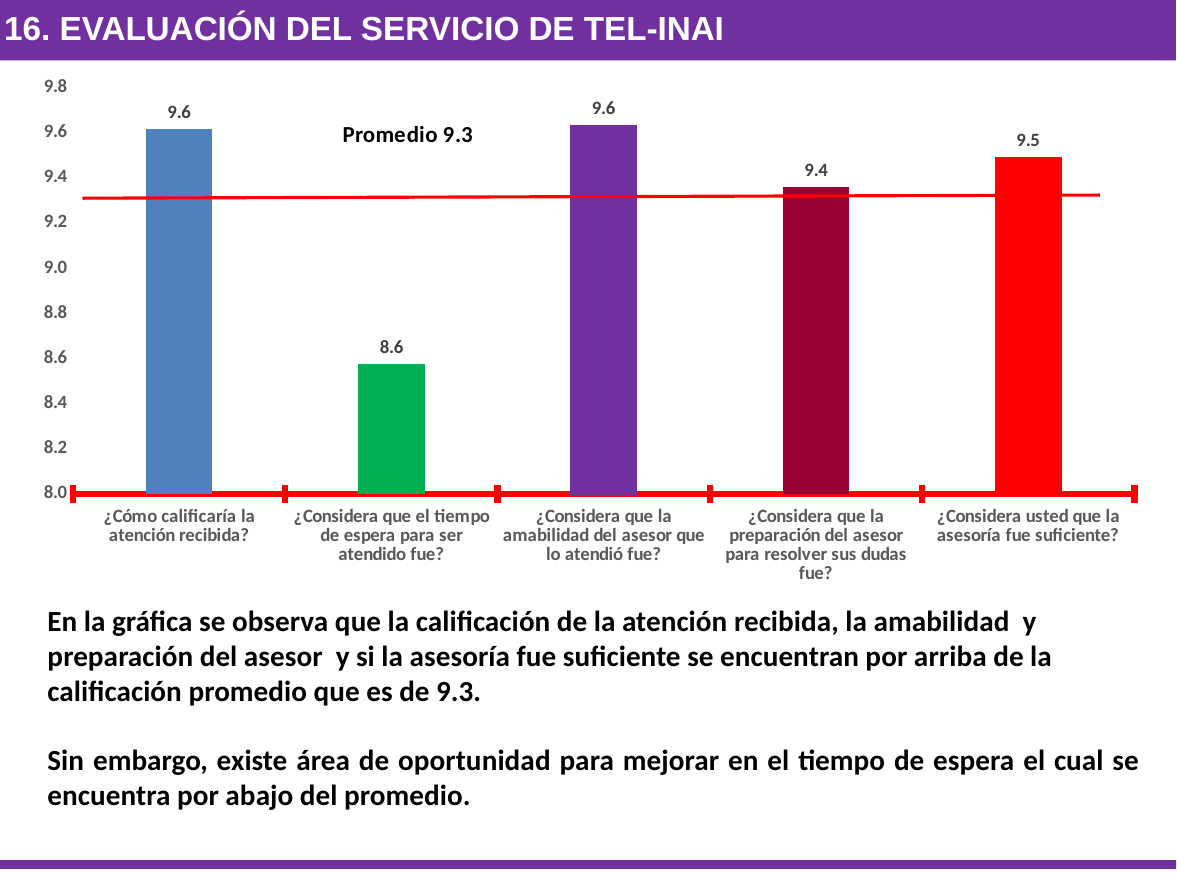
What is the value for "¿Considera que el tiempo de espera para ser atendido fue?"? 8.6 What colour is the bar for "¿Considera que el tiempo de espera para ser atendido fue?"? green What kind of chart is shown on the slide? bar chart Which category has the lowest value? ¿Considera que el tiempo de espera para ser atendido fue? What is the value for "¿Cómo calificaría la atención recibida?"? 9.6 Which is larger: the value for "¿Considera usted que la asesoría fue suficiente?" or the value for "¿Considera que la preparación del asesor para resolver sus dudas fue?"? ¿Considera usted que la asesoría fue suficiente? What is the value for "¿Considera que la preparación del asesor para resolver sus dudas fue?"? 9.4 Is the value for "¿Considera que el tiempo de espera para ser atendido fue?" greater or less than 9.0? less How many categories (questions) are plotted in the chart? 5 What is the difference between the value for "¿Considera que la amabilidad del asesor que lo atendió fue?" and the value for "¿Considera que el tiempo de espera para ser atendido fue?"? 1.0 What is the value for "¿Considera usted que la asesoría fue suficiente?"? 9.5 What average (Promedio) value is labelled on the chart? 9.3